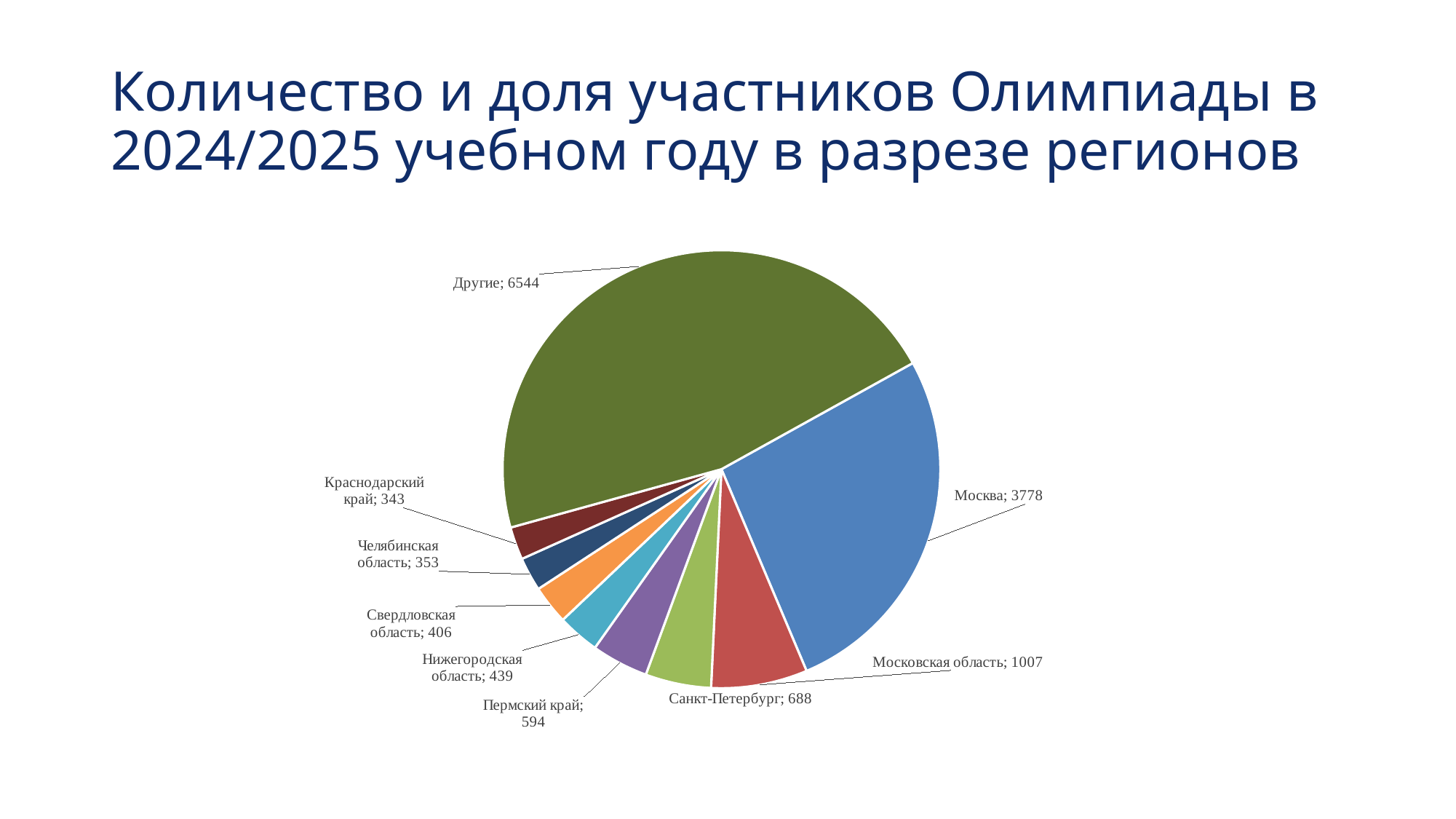
How many slices does the pie chart have? 9 What is the value for Краснодарский край? 343 What is the value for Нижегородская область? 439 What is the value for Москва? 3778 What is the difference between the values for Москва and Московская область? 2771 What is the total of all slices in the pie chart? 14152 Which slice has the largest value? Другие What kind of chart is shown on the slide? pie chart Which is larger, the value for Пермский край or the value for Свердловская область? Пермский край Which slice has the smallest value? Краснодарский край What colour is the slice for Москва? blue What is the value for Санкт-Петербург? 688